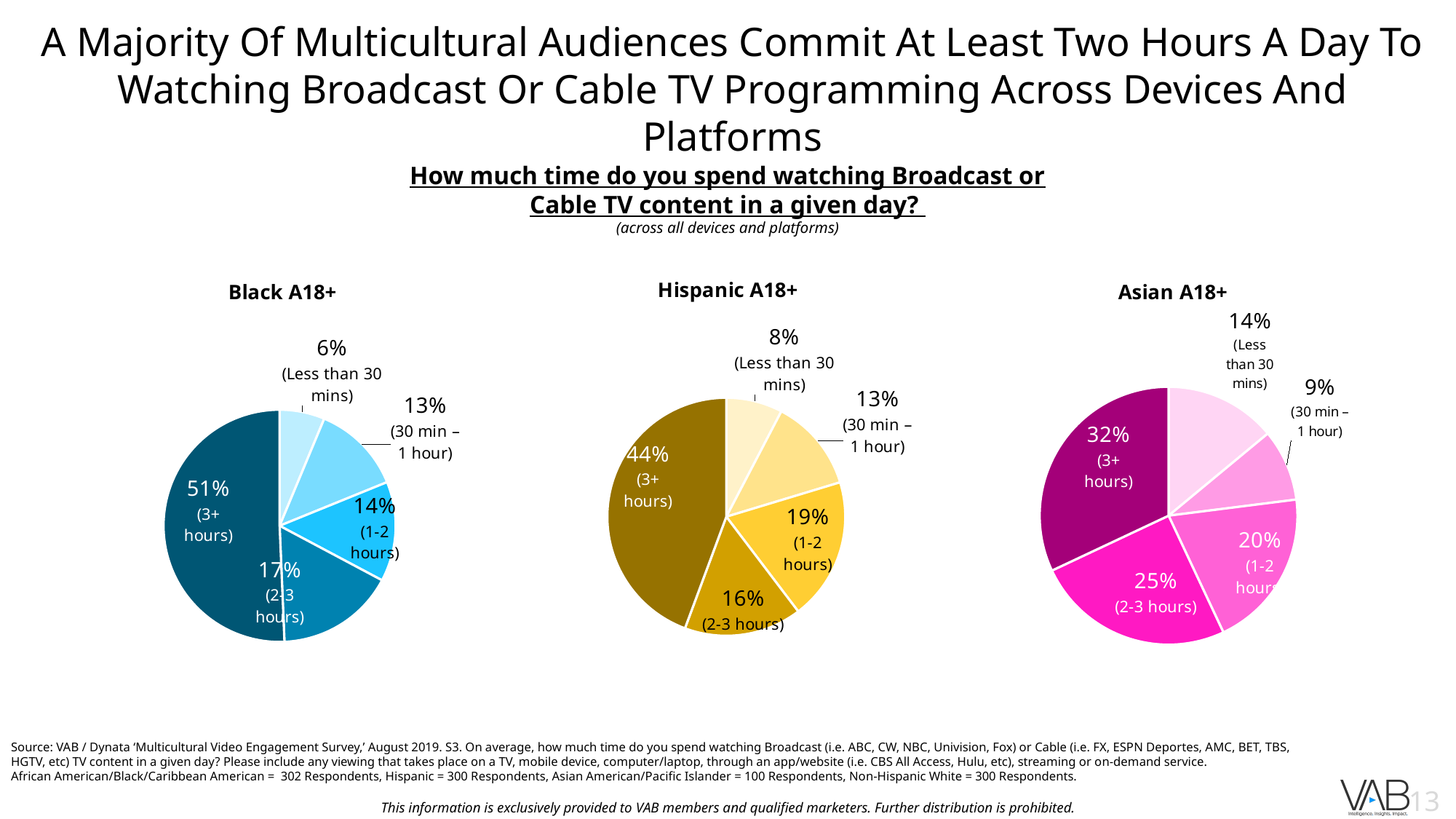
Which is larger: the 2-3 hours share in the Hispanic A18+ chart or the 2-3 hours share in the Asian A18+ chart? Asian A18+ (25%) In the Asian A18+ pie chart, what percentage watch 2-3 hours? 25% What type of chart is used for the Black A18+ data? Pie chart In the Hispanic A18+ pie chart, what percentage watch 1-2 hours? 19% In the Black A18+ pie chart, what share of respondents watch 3+ hours? 51% In the Hispanic A18+ pie chart, which category has the smallest share? Less than 30 mins In the Asian A18+ pie chart, which category has the largest share? 3+ hours In the Black A18+ pie chart, which category has the smallest share? Less than 30 mins How many slices does the Hispanic A18+ pie chart have? 5 What is the difference between the 3+ hours share in the Black A18+ chart and the 3+ hours share in the Asian A18+ chart? 19 percentage points In the Asian A18+ pie chart, what is the combined share of respondents watching 2-3 hours and 3+ hours? 57% How many pie charts are shown on the slide? 3